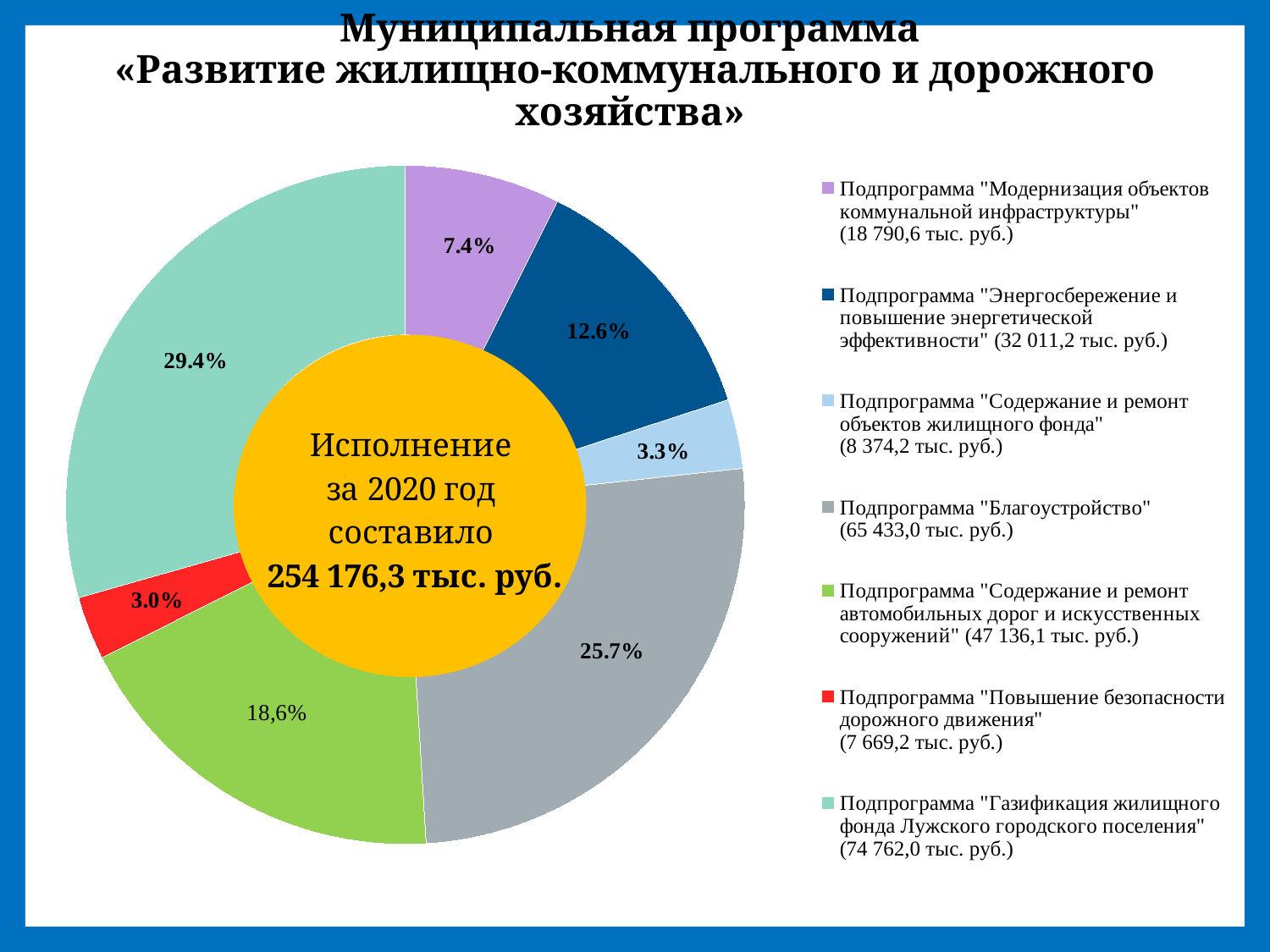
What is the difference in percentage points between the "Газификация жилищного фонда" slice and the "Благоустройство" slice? 3.7% What percentage is shown for the subprogram "Содержание и ремонт автомобильных дорог и искусственных сооружений"? 18,6% How many subprograms (slices) does the chart show? 7 According to the legend, what amount in тыс. руб. corresponds to the subprogram "Благоустройство"? 65 433,0 тыс. руб. What percentage is shown for the subprogram "Энергосбережение и повышение энергетической эффективности"? 12.6% What total amount is stated in the centre of the chart as the 2020 execution? 254 176,3 тыс. руб. What is the difference between the "Энергосбережение" slice and the "Модернизация объектов коммунальной инфраструктуры" slice? 5.2% Which subprogram has the smallest share of the chart? Повышение безопасности дорожного движения What kind of chart is shown on the slide? doughnut chart What share of the chart does the subprogram "Благоустройство" account for? 25.7% Which subprogram has the largest share of the chart? Газификация жилищного фонда Лужского городского поселения Which slice is larger: "Содержание и ремонт объектов жилищного фонда" or "Модернизация объектов коммунальной инфраструктуры"? Модернизация объектов коммунальной инфраструктуры